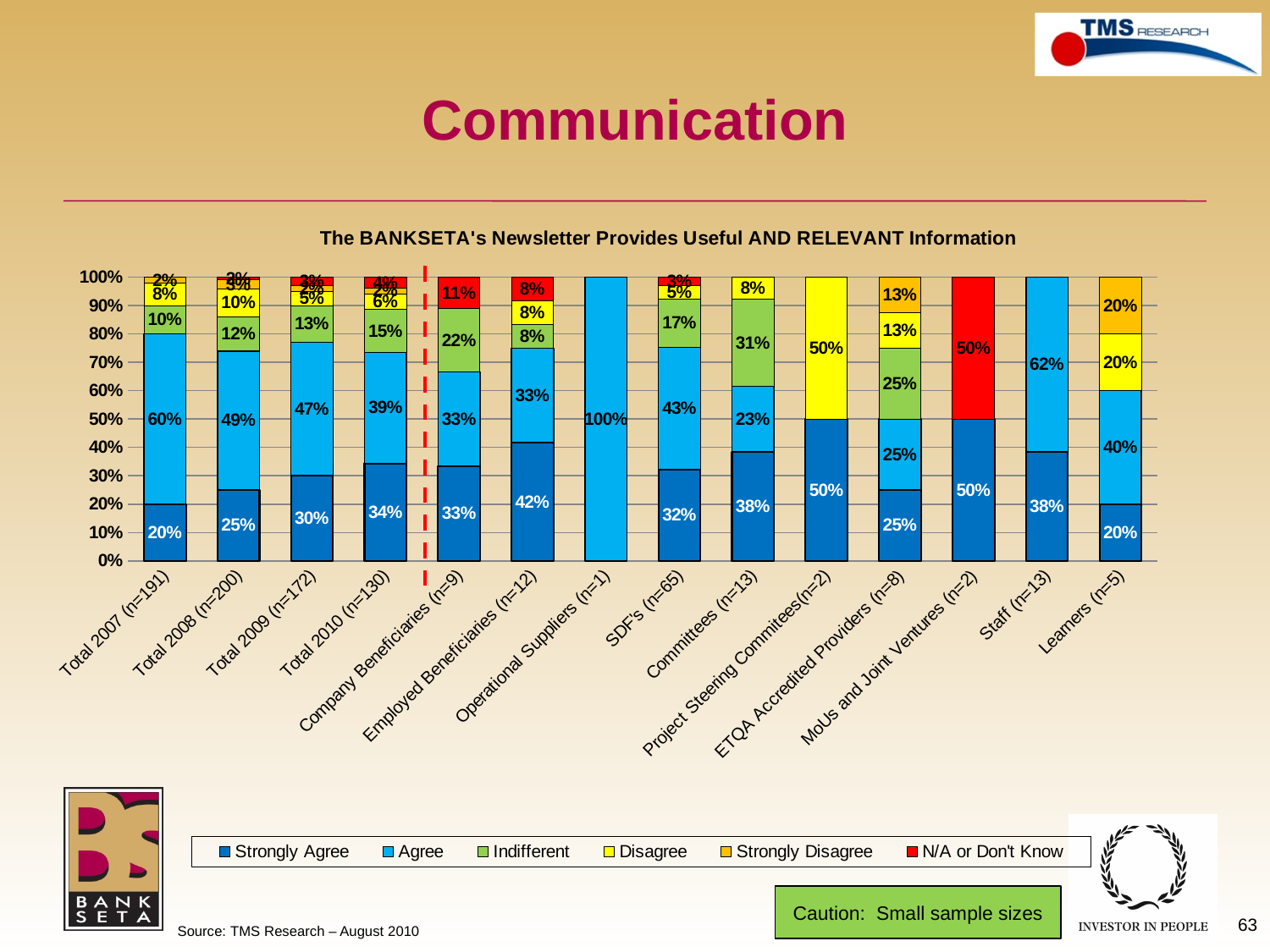
What is the Agree value for Operational Suppliers (n=1)? 100% What percentage of Total 2007 (n=191) respondents Strongly Agree that the BANKSETA's Newsletter provides useful and relevant information? 20% Which has the larger Agree value, Total 2007 (n=191) or Total 2008 (n=200)? Total 2007 (n=191) What is the Indifferent value for Committees (n=13)? 31% How many series does the legend list? 6 What is the title of the chart? The BANKSETA's Newsletter Provides Useful AND RELEVANT Information What kind of chart is shown on the slide? Stacked bar chart Among the four Total year categories, which has the highest Strongly Agree value? Total 2010 (n=130) What is the difference between the Strongly Agree values for Total 2010 (n=130) and Total 2007 (n=191)? 14 percentage points What is the Agree value for Staff (n=13)? 62% Does the Strongly Agree value rise or fall from Total 2007 to Total 2010? Rises How many categories are shown along the x axis? 14